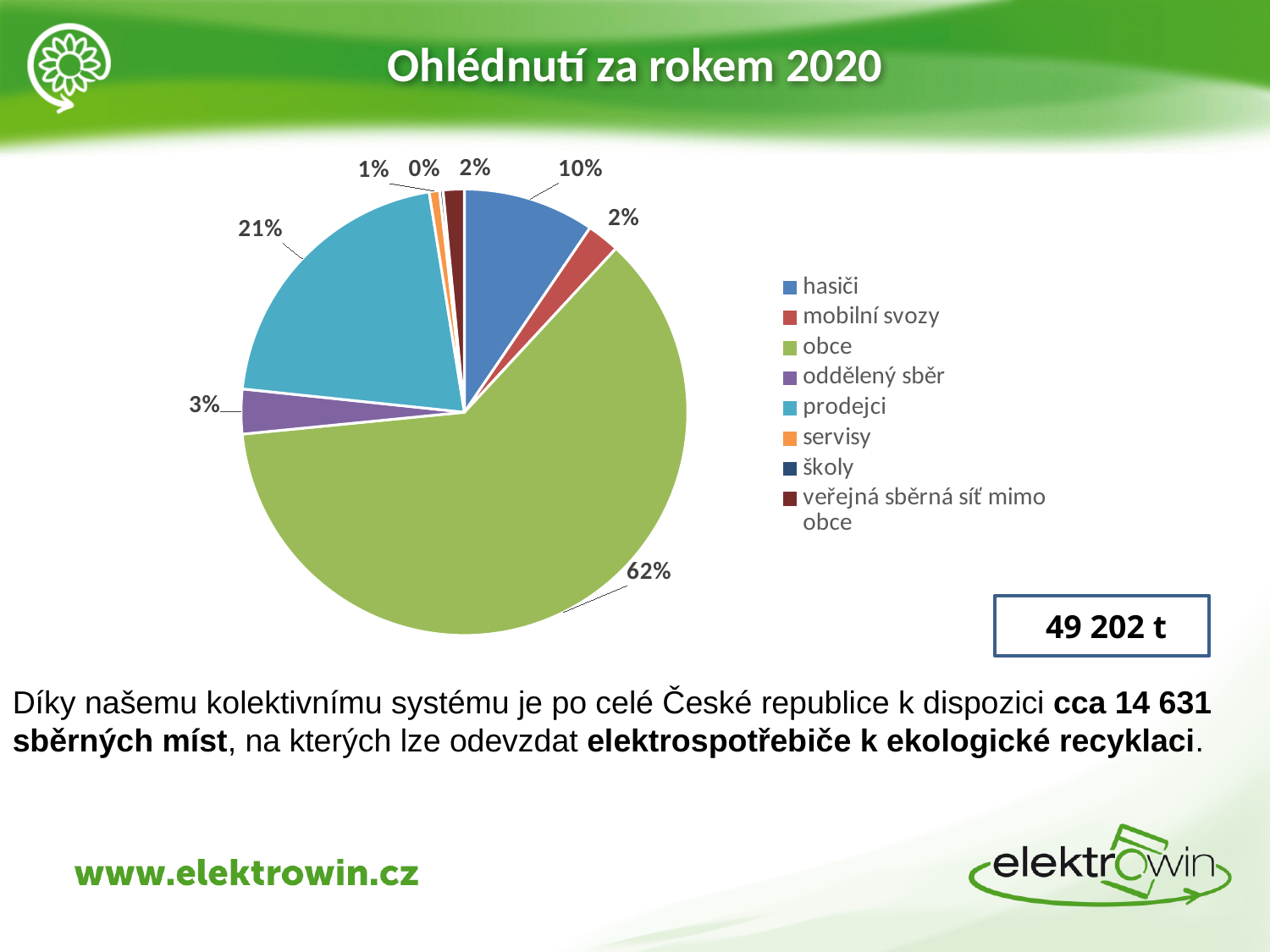
What is the difference between the shares of obce and prodejci? 41% What share of the pie does obce represent? 62% Which is larger, the share for hasiči or the share for oddělený sběr? hasiči What value is shown in the box to the right of the chart? 49 202 t How many categories does the legend list? 8 What share of the pie does prodejci represent? 21% What is the value shown for servisy? 1% Which category has the smallest slice of the pie? školy What is the value shown for hasiči? 10% Which category has the largest slice of the pie? obce What kind of chart is shown on the slide? pie chart What is the value shown for oddělený sběr? 3%